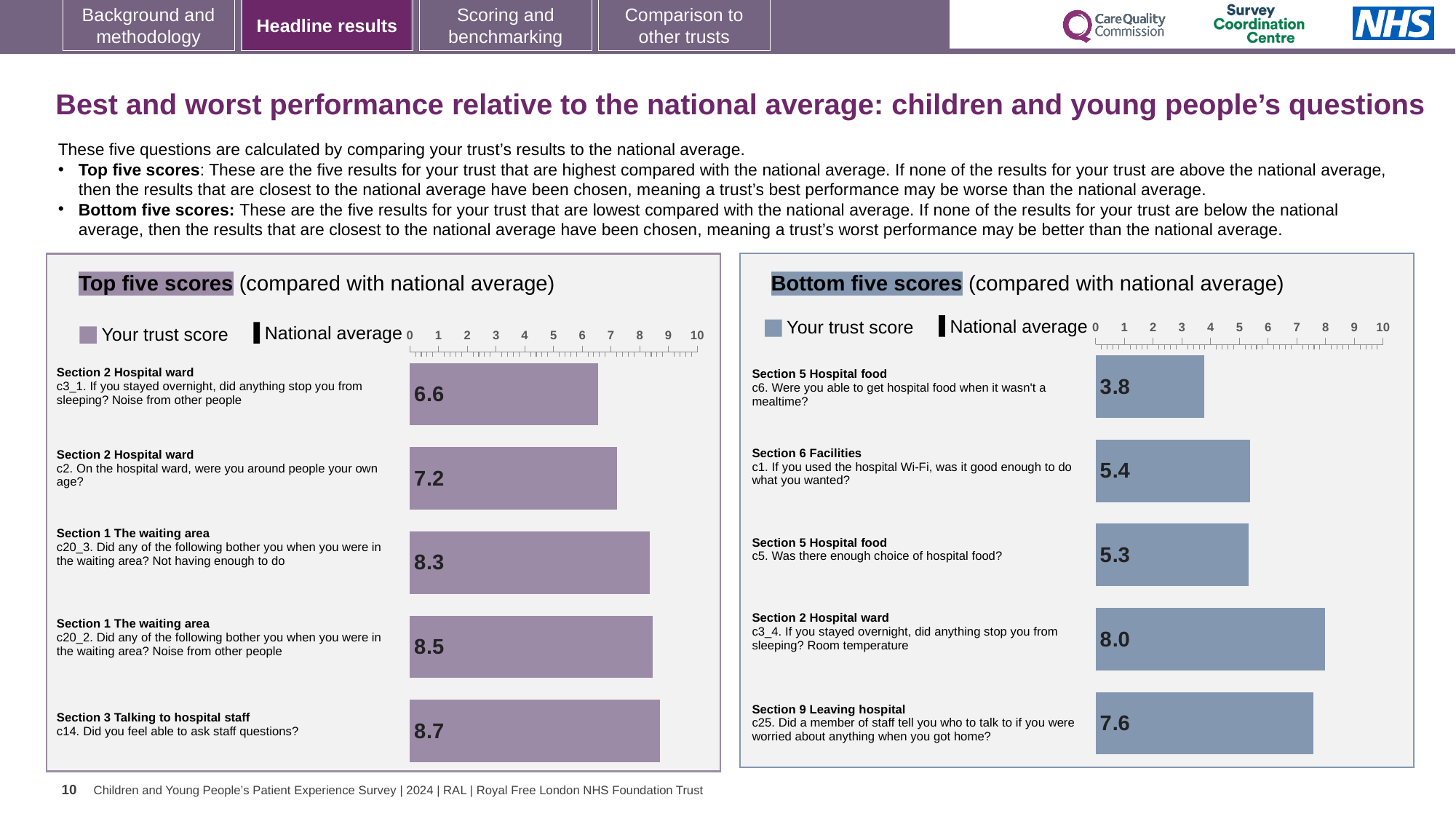
What type of chart is used for the Top five scores? Bar chart In the Bottom five scores chart, what is the trust score for c6 'Were you able to get hospital food when it wasn't a mealtime?' 3.8 In the Top five scores chart, what is the difference between the trust score for c14 (ask staff questions) and c3_1 (noise from other people)? 2.1 How many questions are plotted in the Top five scores chart? 5 In the Bottom five scores chart, is the trust score for c1 (hospital Wi-Fi) greater or less than 7? less In the Bottom five scores chart, what is the difference between the trust score for c3_4 (room temperature) and c6 (hospital food when it wasn't a mealtime)? 4.2 In the Top five scores chart, what is the trust score for c20_3 'Did any of the following bother you when you were in the waiting area? Not having enough to do'? 8.3 In the Bottom five scores chart, which has the larger trust score: c3_4 (room temperature) or c25 (who to talk to if worried when you got home)? c3_4 (room temperature) In the Top five scores chart, what is the trust score for c2 'On the hospital ward, were you around people your own age?' 7.2 In the Bottom five scores chart, which question has the lowest trust score? c6. Were you able to get hospital food when it wasn't a mealtime? In the Top five scores chart, which question has the highest trust score? c14. Did you feel able to ask staff questions? In the Bottom five scores chart, which question has the highest trust score? c3_4. If you stayed overnight, did anything stop you from sleeping? Room temperature